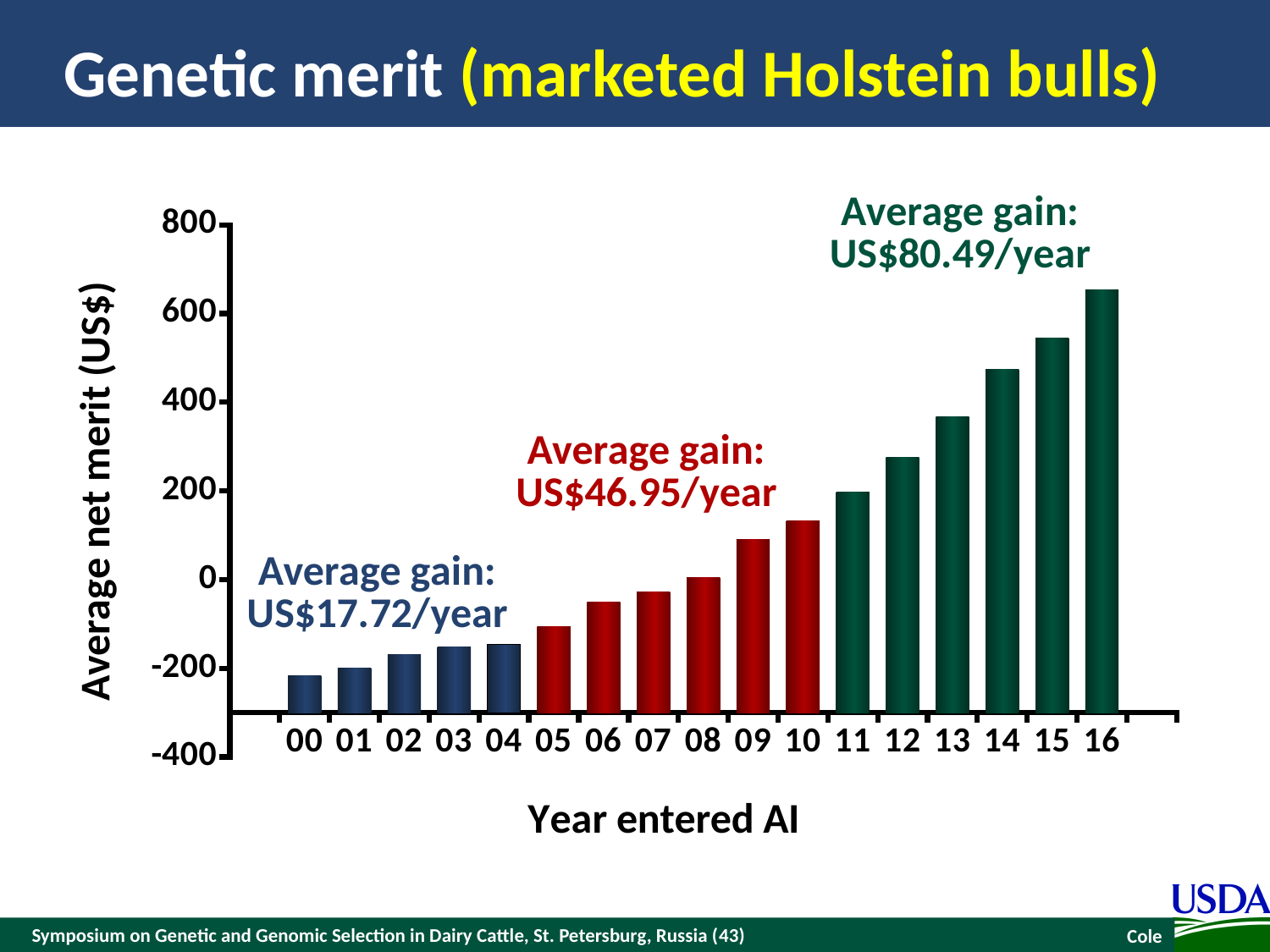
Is the average net merit for year 05 greater or less than 0? less Which has the larger average net merit, year 12 or year 09? 12 How many years (bars) are plotted on the x axis? 17 Is the average net merit for year 15 greater or less than 600? less Which year entered AI has the highest average net merit? 16 Is the average net merit for year 14 greater or less than 400? greater What is the label of the y axis? Average net merit (US$) What average gain per year is stated for the green bars (years 11 to 16)? US$80.49/year Do the average net merit values rise or fall as the year entered AI increases? rise Which year entered AI has the lowest average net merit? 00 What kind of chart is shown on the slide? bar chart